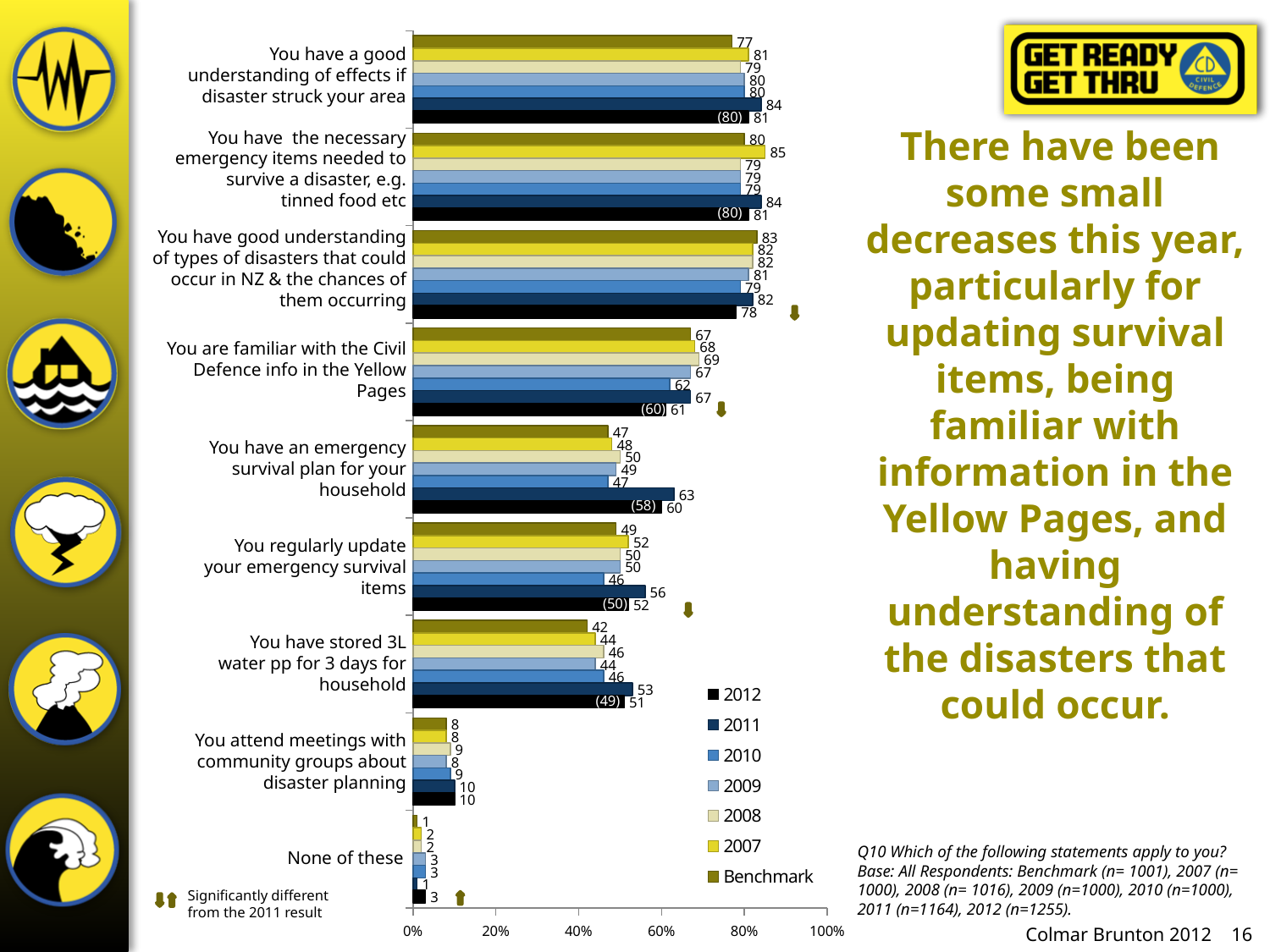
How many series does the chart legend list? 7 Which series has the highest value for 'You have the necessary emergency items needed to survive a disaster'? 2007 What is the 2010 value for 'You are familiar with the Civil Defence info in the Yellow Pages'? 62 For 2011, which is larger: 'You have an emergency survival plan for your household' or 'You regularly update your emergency survival items'? You have an emergency survival plan for your household What is the difference between the 2011 and 2012 values for 'You regularly update your emergency survival items'? 4 What colour represents the 2012 series in the legend? black Which category has the lowest 2012 value? None of these What is the 2012 value for 'You have stored 3L water pp for 3 days for household'? 51 What is the 2011 value for 'You have an emergency survival plan for your household'? 63 How many statement categories are plotted on the chart? 9 What kind of chart is shown on the slide? bar chart What is the 2007 value for 'You have the necessary emergency items needed to survive a disaster'? 85